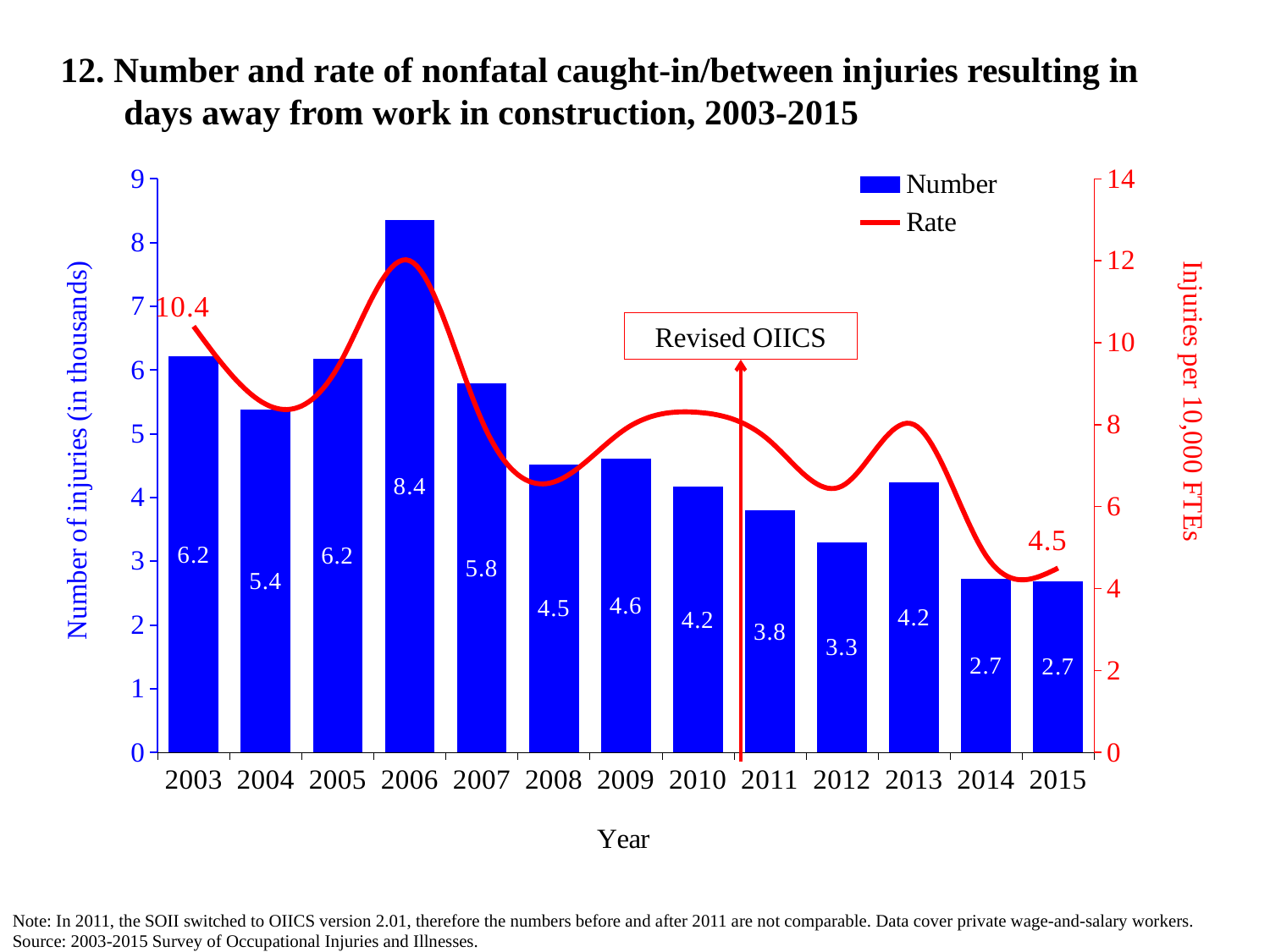
What is the difference in the number of injuries (in thousands) between 2006 and 2007? 2.6 Which year has a larger number of injuries, 2009 or 2011? 2009 Is the rate of injuries per 10,000 FTEs in 2006 greater or less than 10? greater What is the label of the right-hand vertical axis? Injuries per 10,000 FTEs How many years are shown on the x axis? 13 What is the number of injuries (in thousands) for 2012? 3.3 What is the number of injuries (in thousands) for 2006? 8.4 What is the rate of injuries per 10,000 FTEs in 2003? 10.4 What kind of chart is used to show the Number series? bar chart What is the rate of injuries per 10,000 FTEs in 2015? 4.5 Which year has the highest number of injuries? 2006 How many series does the legend list? 2